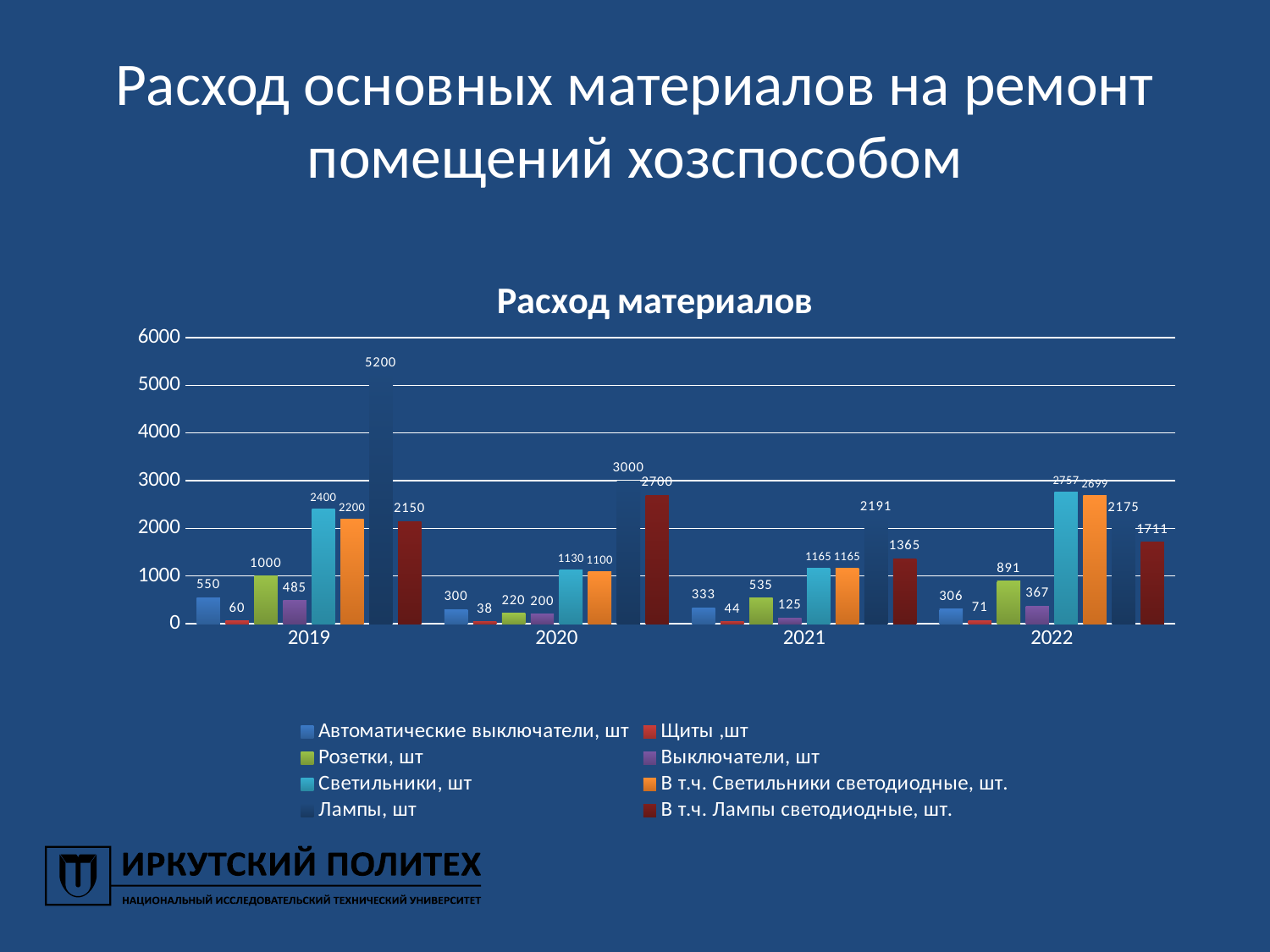
What kind of chart is shown? bar chart In which year is the value for Светильники, шт the highest? 2022 What is the value for Розетки, шт in 2022? 891 What is the difference between the Лампы, шт values for 2019 and 2020? 2200 Which is larger: Автоматические выключатели, шт in 2019 or in 2022? 2019 What is the title of the chart? Расход материалов What is the value for Лампы, шт in 2019? 5200 How many series does the legend list? 8 What is the value for В т.ч. Лампы светодиодные, шт. in 2020? 2700 In which year is the value for Щиты, шт the lowest? 2020 How many years are shown on the x axis? 4 What is the value for Щиты, шт in 2021? 44